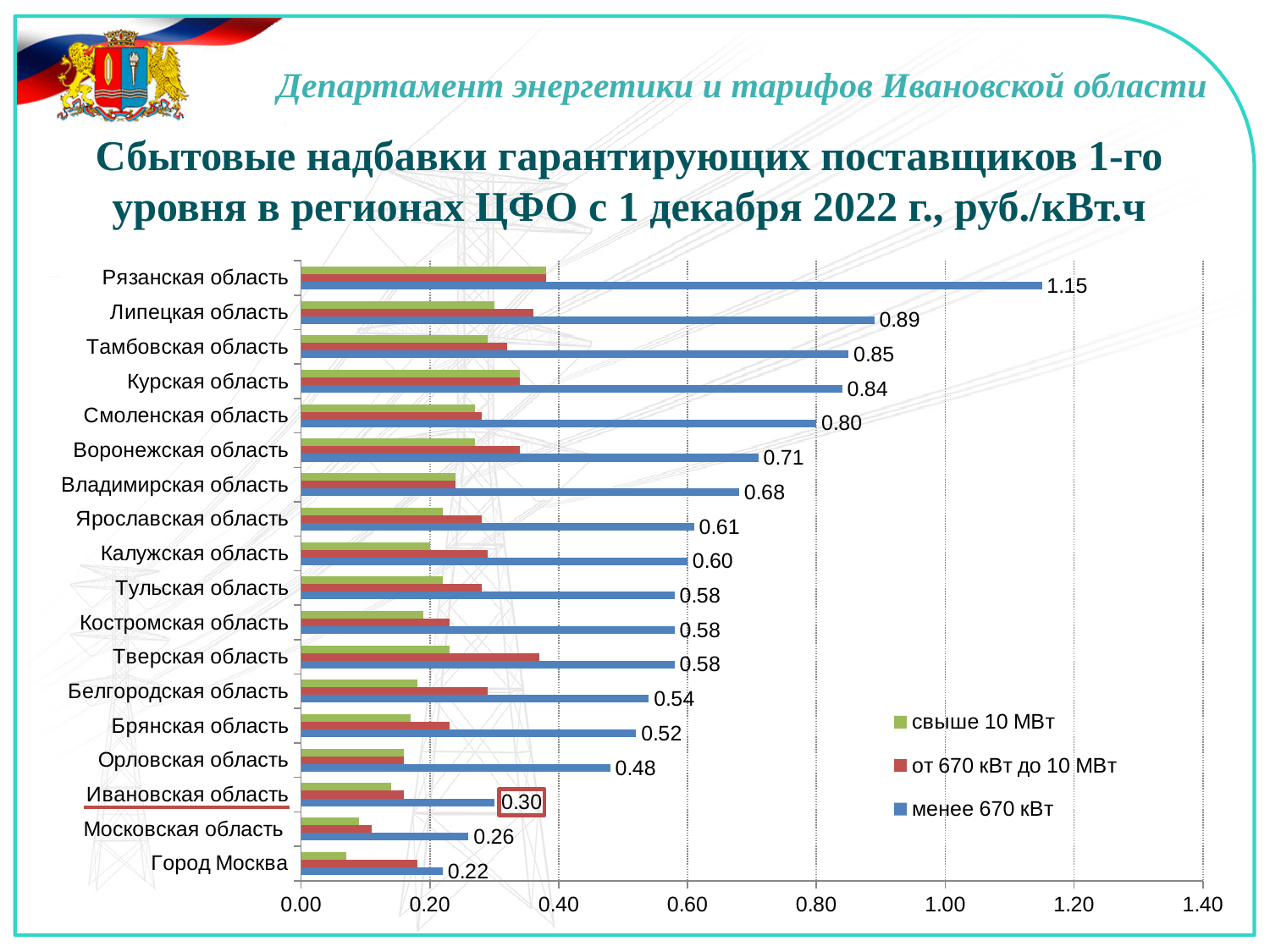
How many regions are shown on the chart? 18 Which series is shown in blue according to the legend? менее 670 кВт What kind of chart is shown on the slide? bar chart Which region has the lowest value in the series "менее 670 кВт"? Город Москва What is the value for Рязанская область in the series "менее 670 кВт"? 1.15 Which region has the highest value in the series "менее 670 кВт"? Рязанская область Is the value for Рязанская область in the series "свыше 10 МВт" greater or less than 0.60? less Which is larger in the series "менее 670 кВт": Воронежская область or Владимирская область? Воронежская область How many series does the legend list? 3 What is the value for Ивановская область in the series "менее 670 кВт"? 0.30 What is the value for Город Москва in the series "менее 670 кВт"? 0.22 What is the difference between the "менее 670 кВт" values for Рязанская область and Липецкая область? 0.26